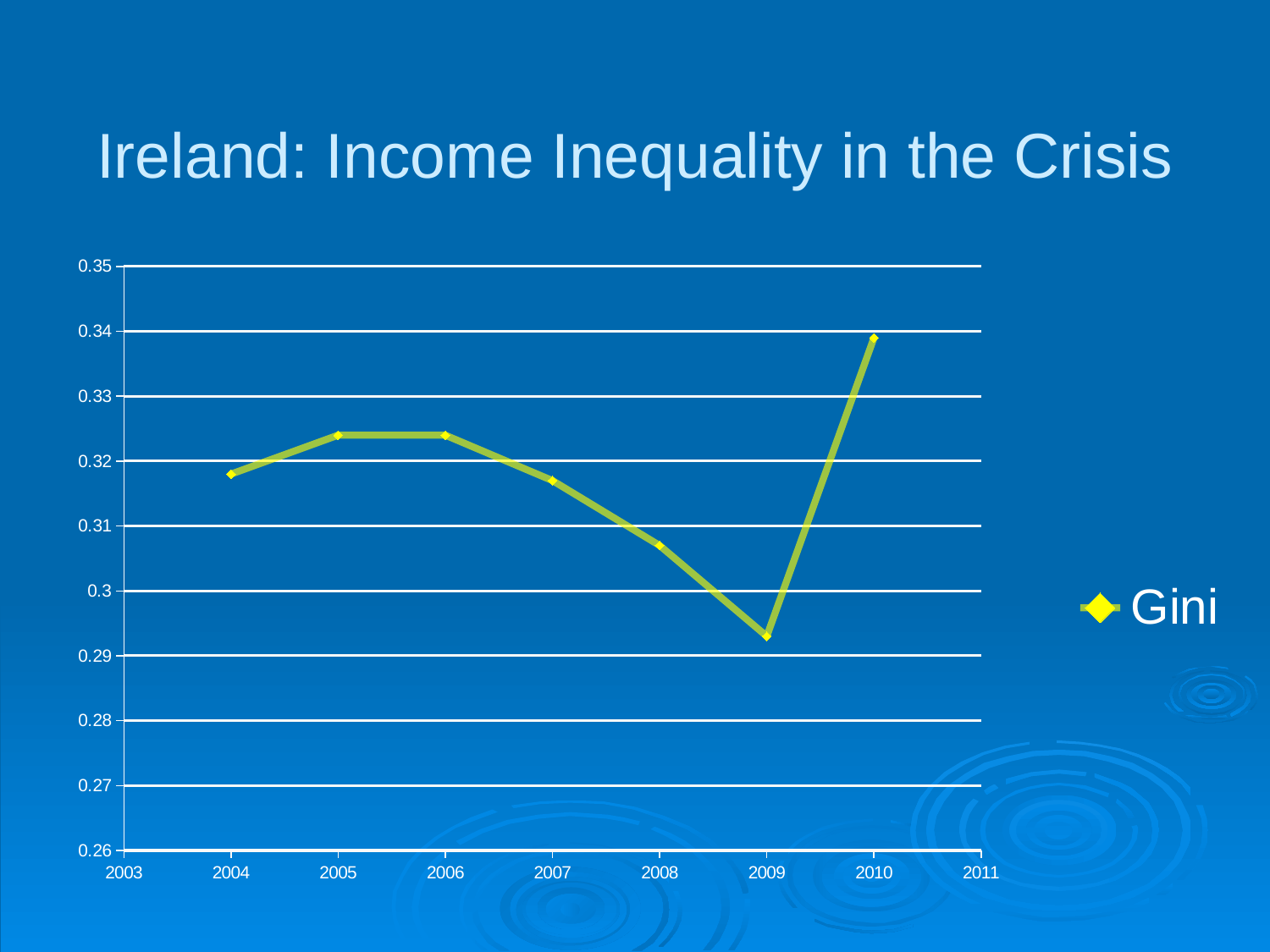
Is the Gini value for 2010 greater or less than 0.33? greater What is the name of the series shown in the legend? Gini How many data points are plotted on the Gini line? 7 Is the Gini value for 2009 greater or less than 0.3? less Is the Gini value for 2008 greater or less than 0.3? greater How many series does the legend list? 1 Which year has the larger Gini value, 2005 or 2008? 2005 Does the Gini value rise or fall from 2006 to 2009? fall In which year is the Gini value lowest? 2009 In which year is the Gini value highest? 2010 What kind of chart is shown on the slide? line chart What is the title of the chart? Ireland: Income Inequality in the Crisis